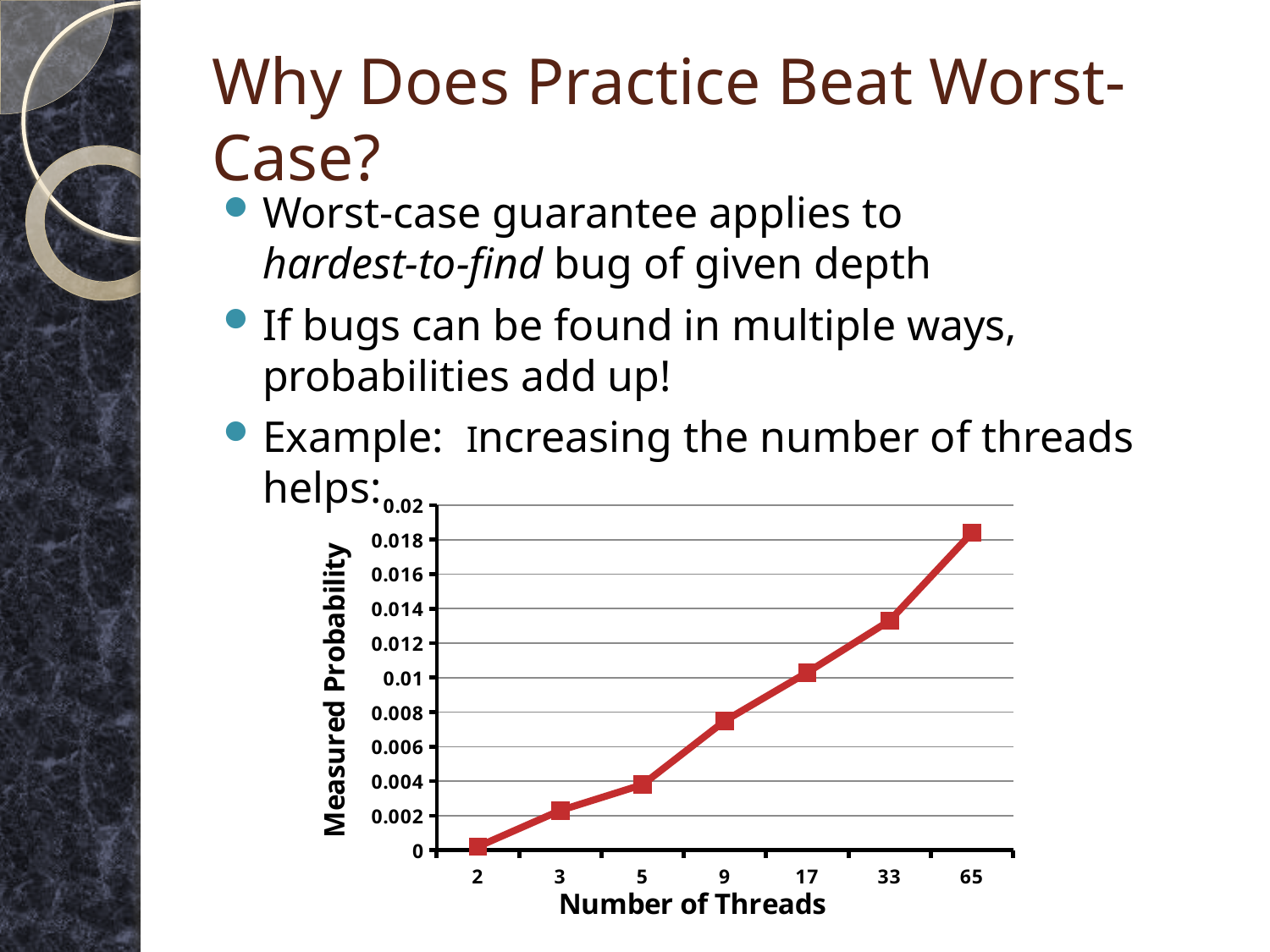
What is the label of the x axis of the chart? Number of Threads Which number of threads has the lowest measured probability? 2 Is the measured probability for 17 threads greater or less than 0.008? greater What is the label of the y axis of the chart? Measured Probability What kind of chart is shown on the slide? line chart Is the measured probability for 5 threads greater or less than 0.006? less Which number of threads has the highest measured probability? 65 Which has a larger measured probability: 9 threads or 33 threads? 33 threads Do the values rise or fall as the number of threads increases along the x axis? rise Is the measured probability for 65 threads greater or less than 0.016? greater How many data points are plotted on the chart? 7